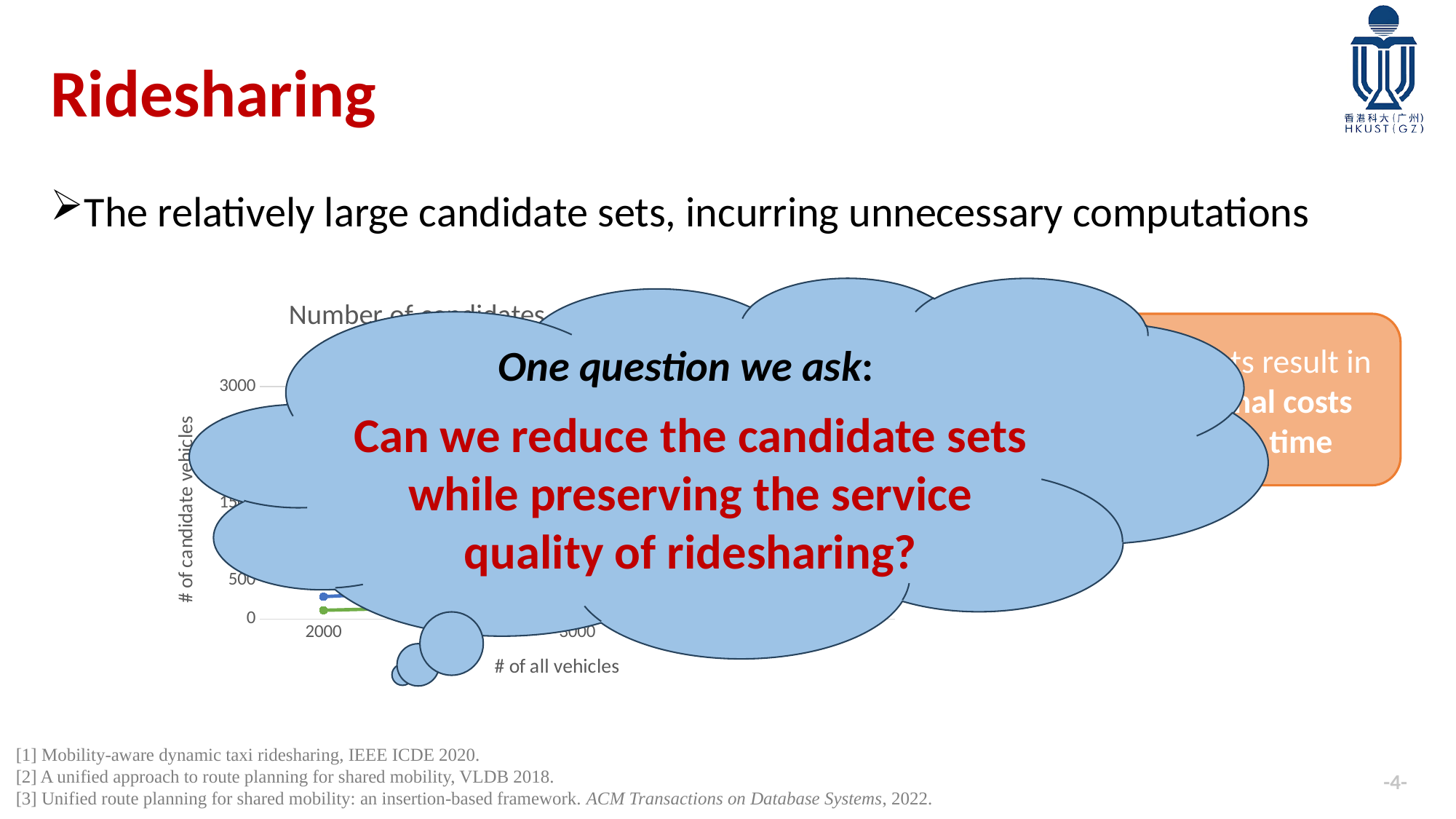
What is the label of the y axis of the chart? # of candidate vehicles Is the value of the blue line at 2000 on the x axis greater or less than 500? less At 2000 on the x axis, which line has the higher value, the blue line or the green line? the blue line What is the label of the x axis of the chart? # of all vehicles What is the highest tick value shown on the y axis of the chart? 3000 Is the value of the green line at 2000 on the x axis greater or less than 500? less What kind of chart is shown on the slide? line chart